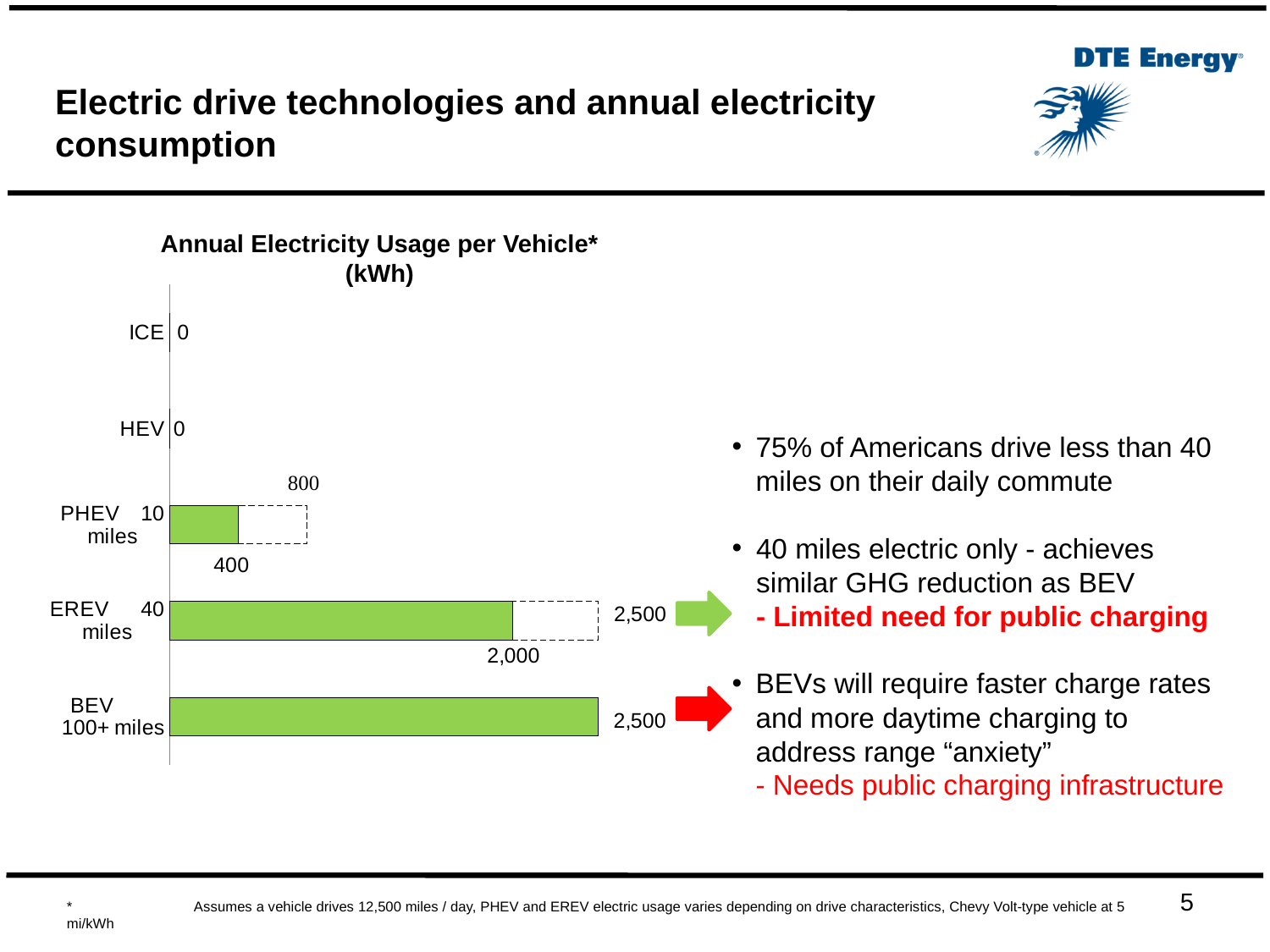
What is the title of the chart? Annual Electricity Usage per Vehicle* (kWh) What value is labelled on the solid green bar for EREV 40 miles? 2,000 What value is shown for HEV in the chart? 0 What value is labelled on the solid green bar for PHEV 10 miles? 400 Which has a larger solid bar value, EREV 40 miles or PHEV 10 miles? EREV 40 miles What type of chart is used to show annual electricity usage per vehicle? Bar chart What is the difference between the BEV 100+ miles value (2,500) and the solid bar value for EREV 40 miles (2,000)? 500 What upper value is labelled above the dashed extension of the PHEV 10 miles bar? 800 Which vehicle category has the highest annual electricity usage? BEV 100+ miles What is the annual electricity usage shown for the BEV 100+ miles category? 2,500 How many vehicle categories are shown in the chart? 5 What value is shown for ICE in the chart? 0